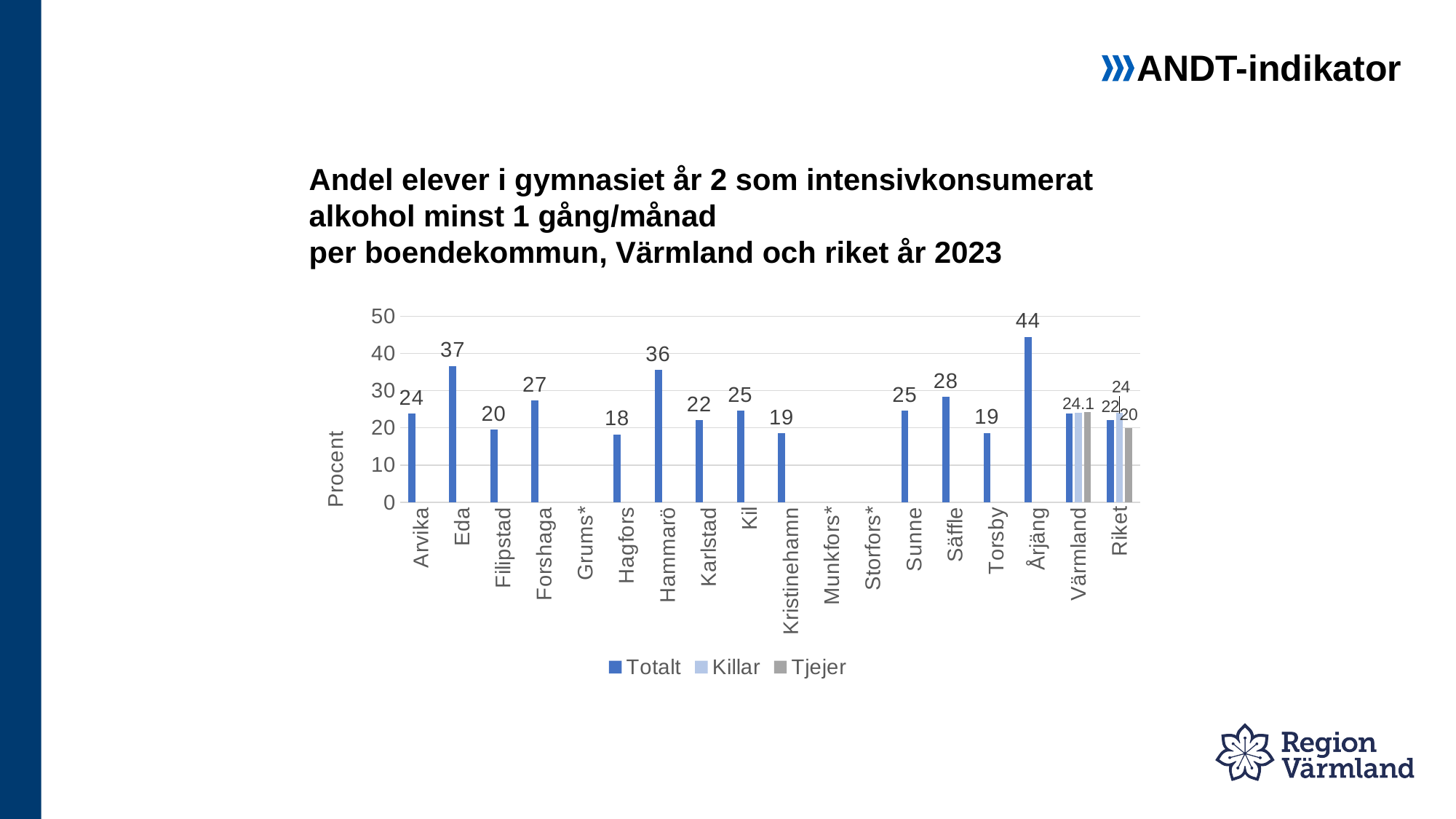
Which municipality has the lowest Totalt value among those with a bar shown? Hagfors What is the Totalt value for Hammarö? 36 Which has a higher Totalt value, Säffle or Karlstad? Säffle What is the Totalt value for Årjäng? 44 What is the label of the y axis? Procent How many series does the legend list? 3 What kind of chart is shown on the slide? Bar chart Which municipality has the highest Totalt value? Årjäng What is the Tjejer value for Riket? 20 How many categories are shown on the x axis? 18 What is the Totalt value for Hagfors? 18 What is the difference between the Totalt values for Eda and Filipstad? 17